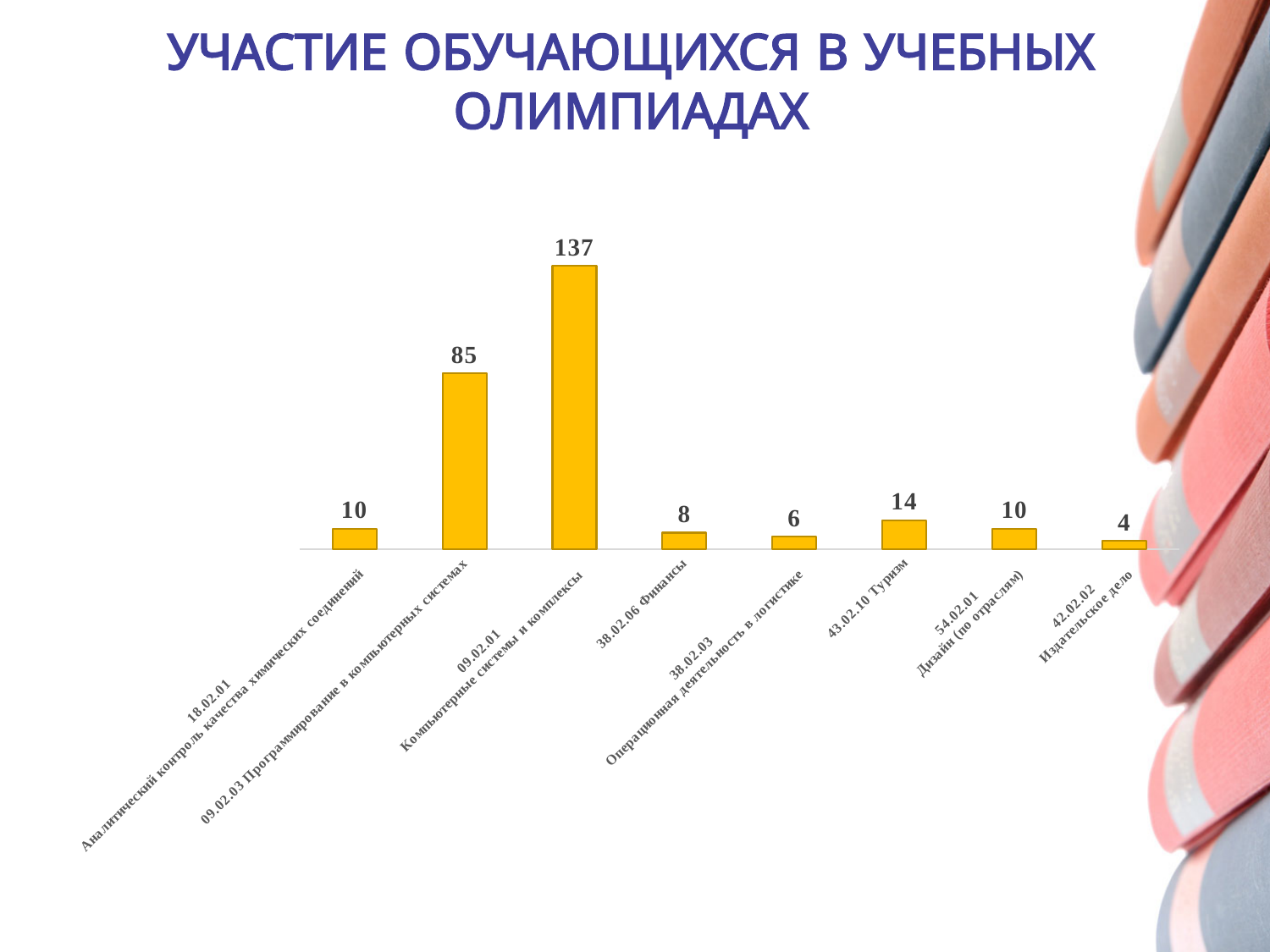
Which category has the lowest value? 42.02.02 Издательское дело What is the difference between the values for 43.02.10 Туризм and 38.02.06 Финансы? 6 How many categories are shown in the chart? 8 What is the value for 09.02.01 Компьютерные системы и комплексы? 137 What is the value for 09.02.03 Программирование в компьютерных системах? 85 Which is larger: the value for 38.02.06 Финансы or the value for 54.02.01 Дизайн (по отраслям)? 54.02.01 Дизайн (по отраслям) What is the title of the slide? УЧАСТИЕ ОБУЧАЮЩИХСЯ В УЧЕБНЫХ ОЛИМПИАДАХ What type of chart is shown on the slide? Bar chart What is the value for 43.02.10 Туризм? 14 What is the difference between the values for 09.02.01 Компьютерные системы и комплексы and 09.02.03 Программирование в компьютерных системах? 52 What is the value for 38.02.03 Операционная деятельность в логистике? 6 Which category has the highest value? 09.02.01 Компьютерные системы и комплексы